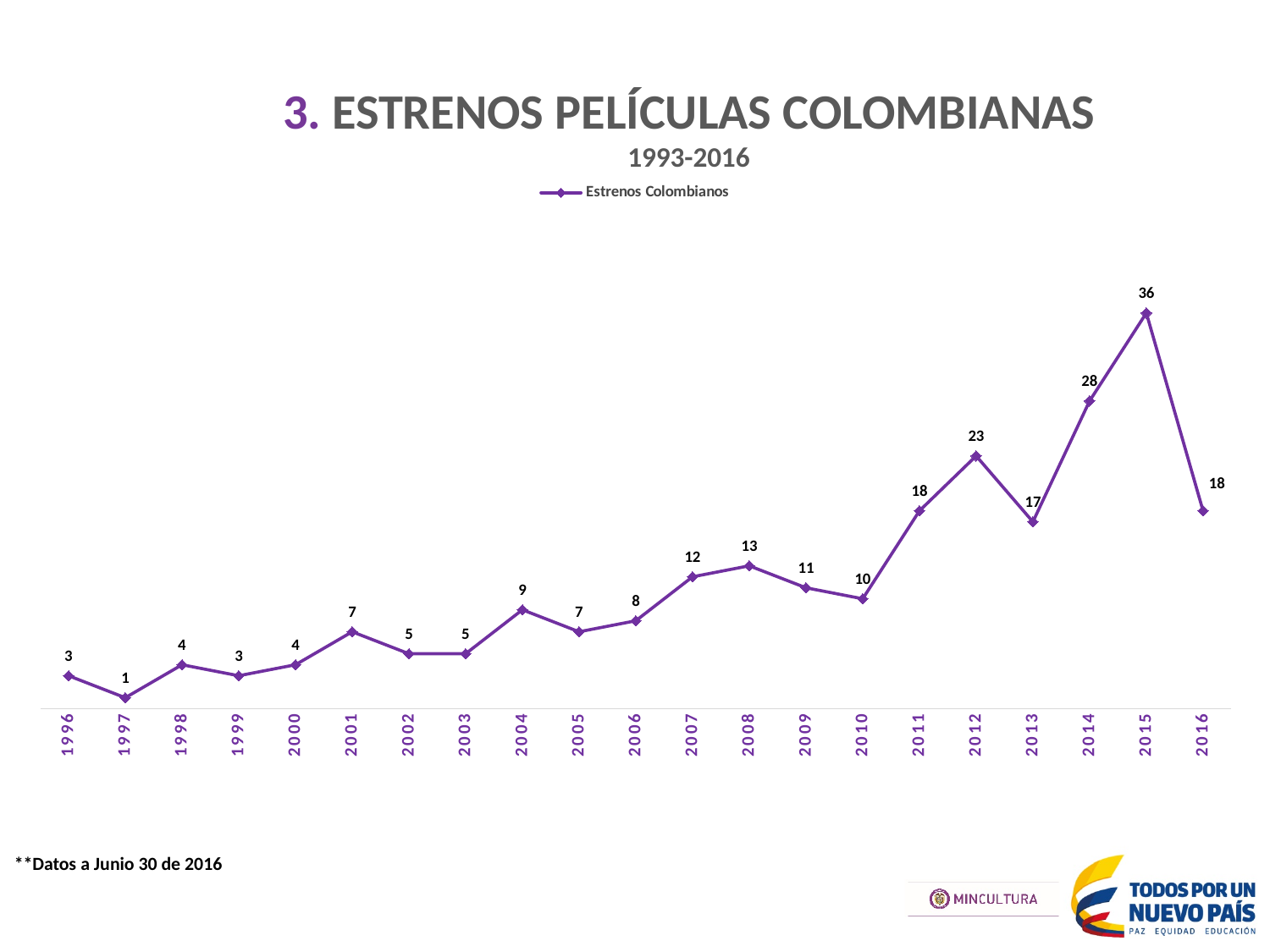
How many series does the legend list? 1 What is the value for 1997? 1 What is the name of the series in the legend? Estrenos Colombianos How many years are plotted on the x axis? 21 Which year has the lowest value? 1997 Which is larger, the value for 2012 or the value for 2011? 2012 What is the value for 2015? 36 What is the difference between the values for 2014 and 2013? 11 What is the value for 2008? 13 Which year has the highest value? 2015 What is the difference between the values for 2015 and 2016? 18 What kind of chart is shown? line chart